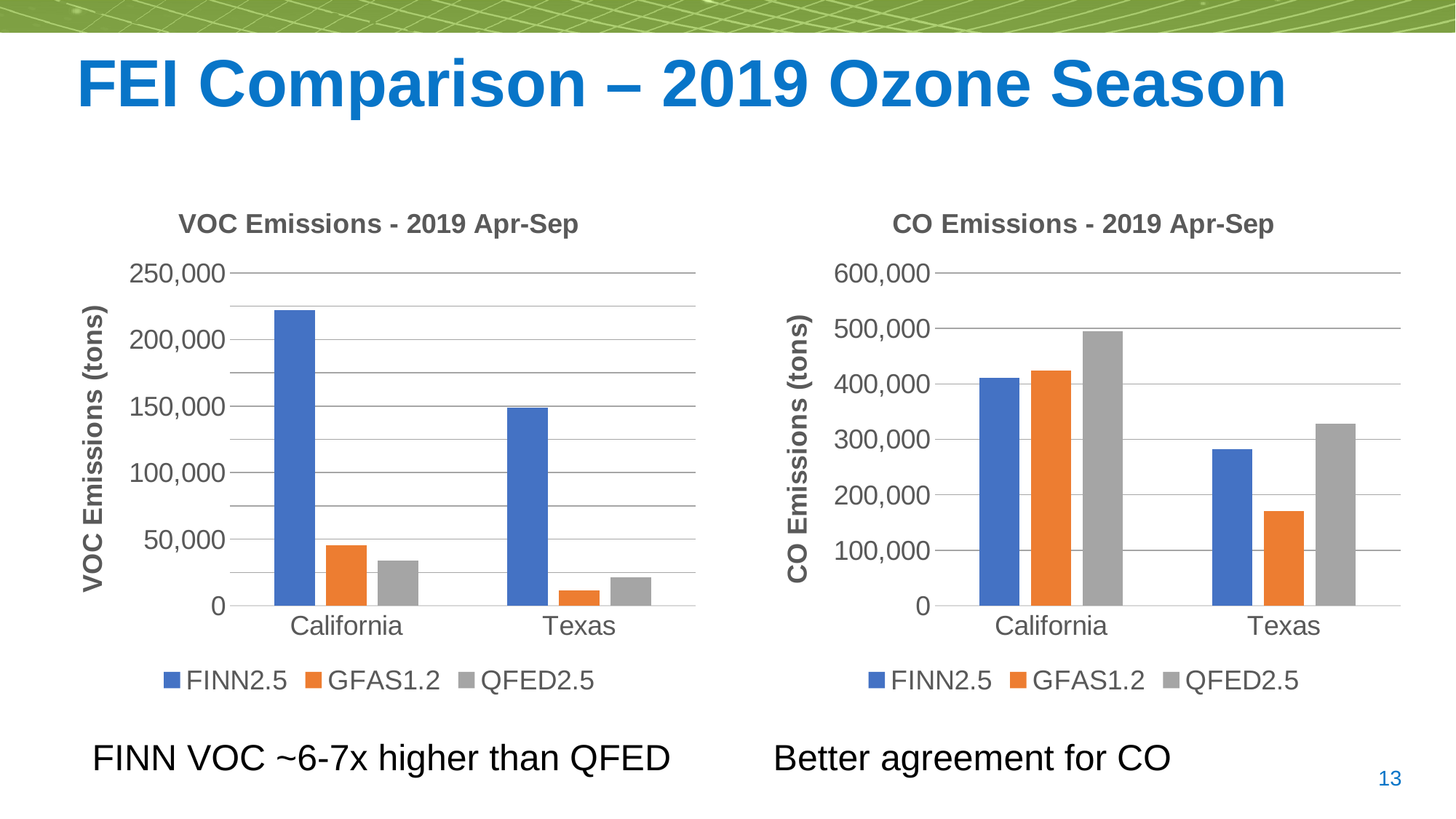
In the VOC Emissions - 2019 Apr-Sep chart, which series has the lowest value for Texas? GFAS1.2 In the CO Emissions - 2019 Apr-Sep chart, is the QFED2.5 value for Texas greater or less than 300,000? greater In the VOC Emissions - 2019 Apr-Sep chart, is the FINN2.5 value for California greater or less than 200,000? greater In the VOC Emissions - 2019 Apr-Sep chart, what kind of chart is shown? bar chart In the CO Emissions - 2019 Apr-Sep chart, which series has the highest value for California? QFED2.5 In the VOC Emissions - 2019 Apr-Sep chart, how many categories are shown on the x axis? 2 In the CO Emissions - 2019 Apr-Sep chart, which series has the lowest value for Texas? GFAS1.2 In the VOC Emissions - 2019 Apr-Sep chart, how many series does the legend list? 3 In the CO Emissions - 2019 Apr-Sep chart, what is the label of the y axis? CO Emissions (tons) In the VOC Emissions - 2019 Apr-Sep chart, which series has the highest value for California? FINN2.5 In the CO Emissions - 2019 Apr-Sep chart, which is larger for Texas, FINN2.5 or GFAS1.2? FINN2.5